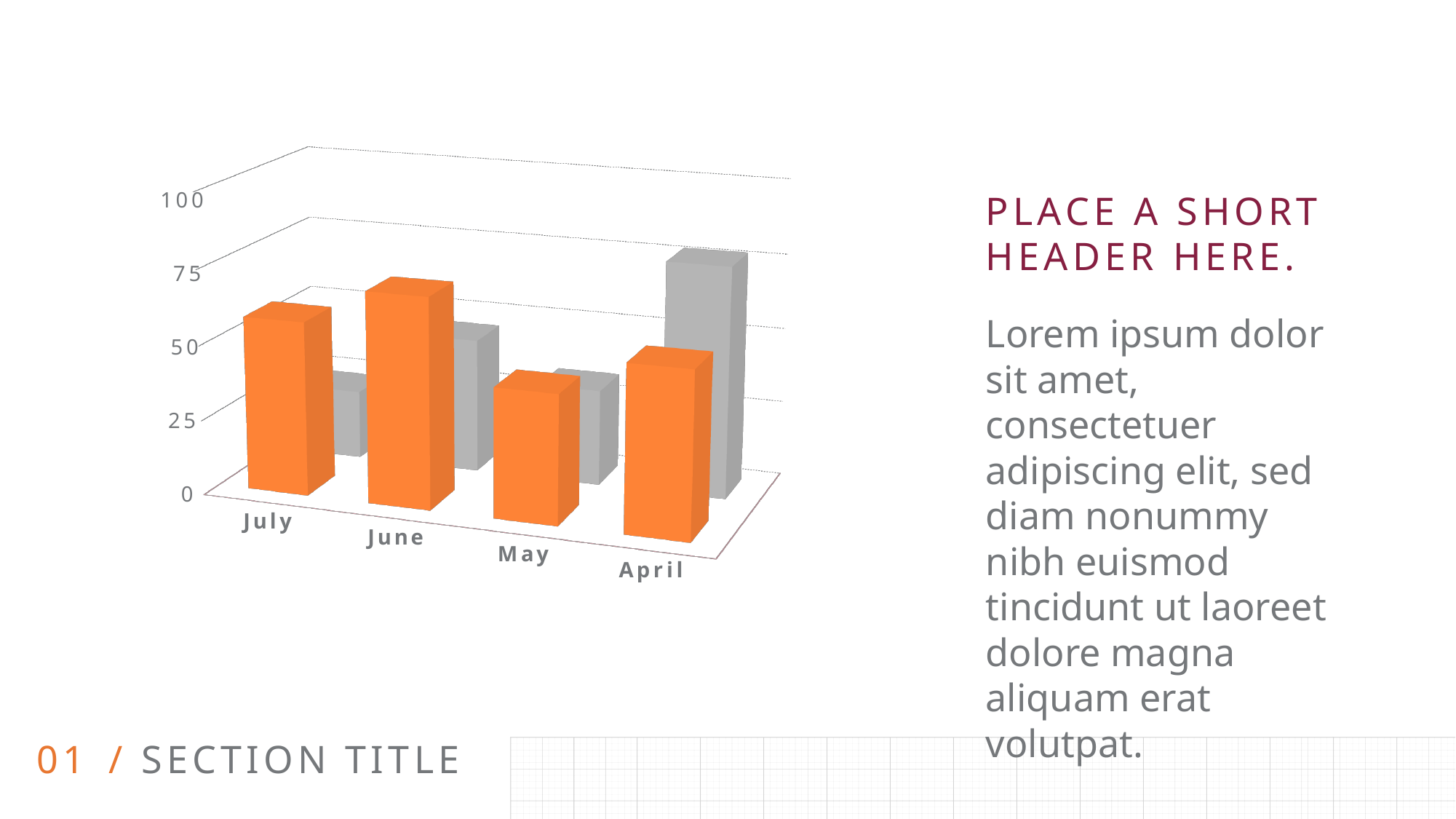
How many bars are plotted for each month in the chart? 2 What kind of chart is shown on the slide? bar chart Is the gray bar for July greater or less than 50? less What two colours are used for the bars in the chart? orange and gray For April, which bar is taller, the orange one or the gray one? gray Is the orange bar for June greater or less than 50? greater Which month has the shortest orange bar? May Which month has the tallest gray bar? April How many categories are shown on the x axis of the chart? 4 Which month has the tallest orange bar? June Which month has the shortest gray bar? July Is the gray bar for April greater or less than 50? greater